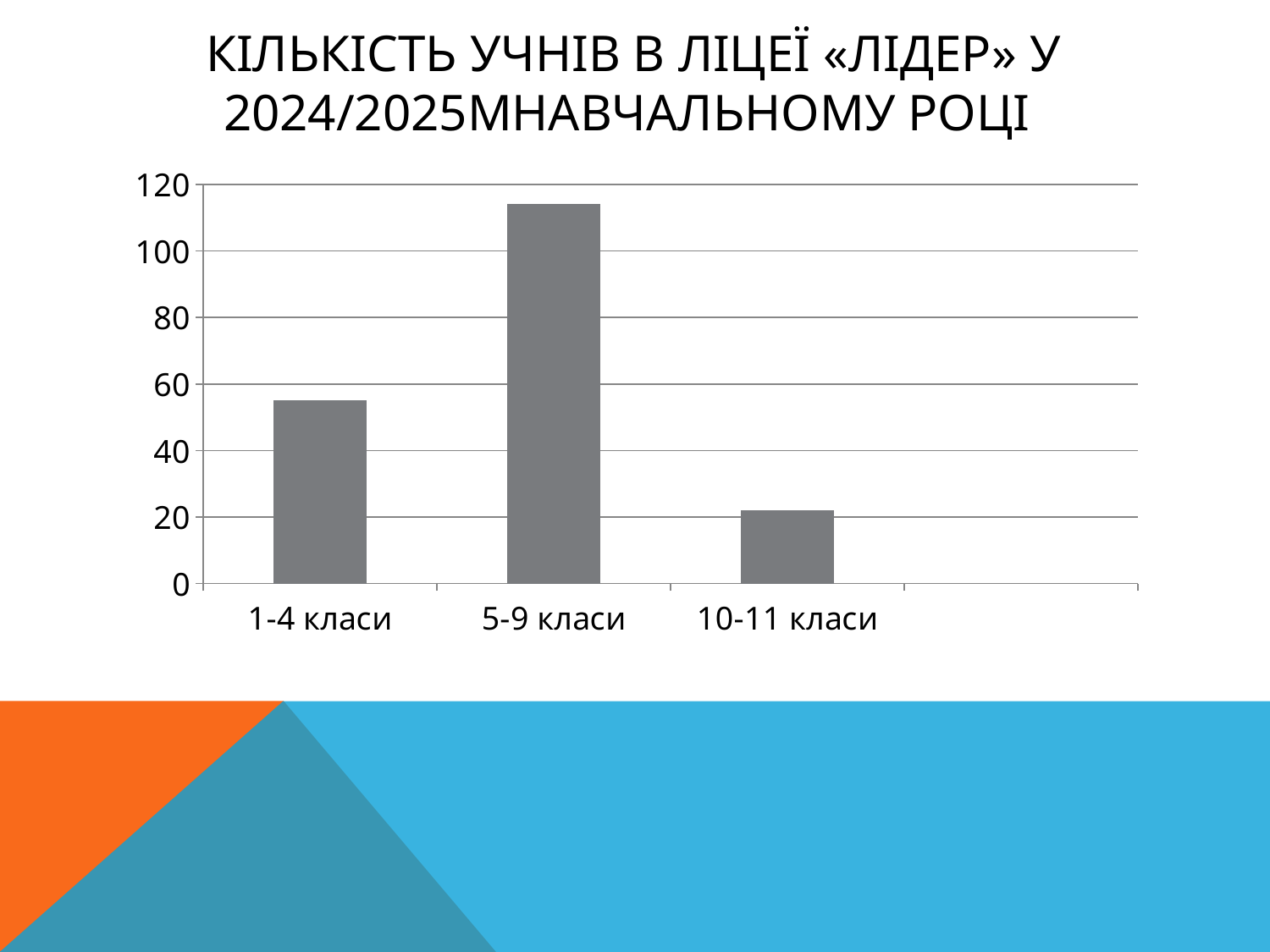
Which category has the lowest value? 10-11 класи Which is larger, the value for 1-4 класи or the value for 10-11 класи? 1-4 класи What is the title of the chart? КІЛЬКІСТЬ УЧНІВ В ЛІЦЕЇ «ЛІДЕР» У 2024/2025МНАВЧАЛЬНОМУ РОЦІ Is the value for 5-9 класи greater or less than 100? greater Which category has the highest value? 5-9 класи How many categories are shown on the x axis of the chart? 3 Which is larger, the value for 5-9 класи or the value for 1-4 класи? 5-9 класи Is the value for 5-9 класи greater or less than 120? less Is the value for 1-4 класи greater or less than 60? less What kind of chart is shown on the slide? bar chart